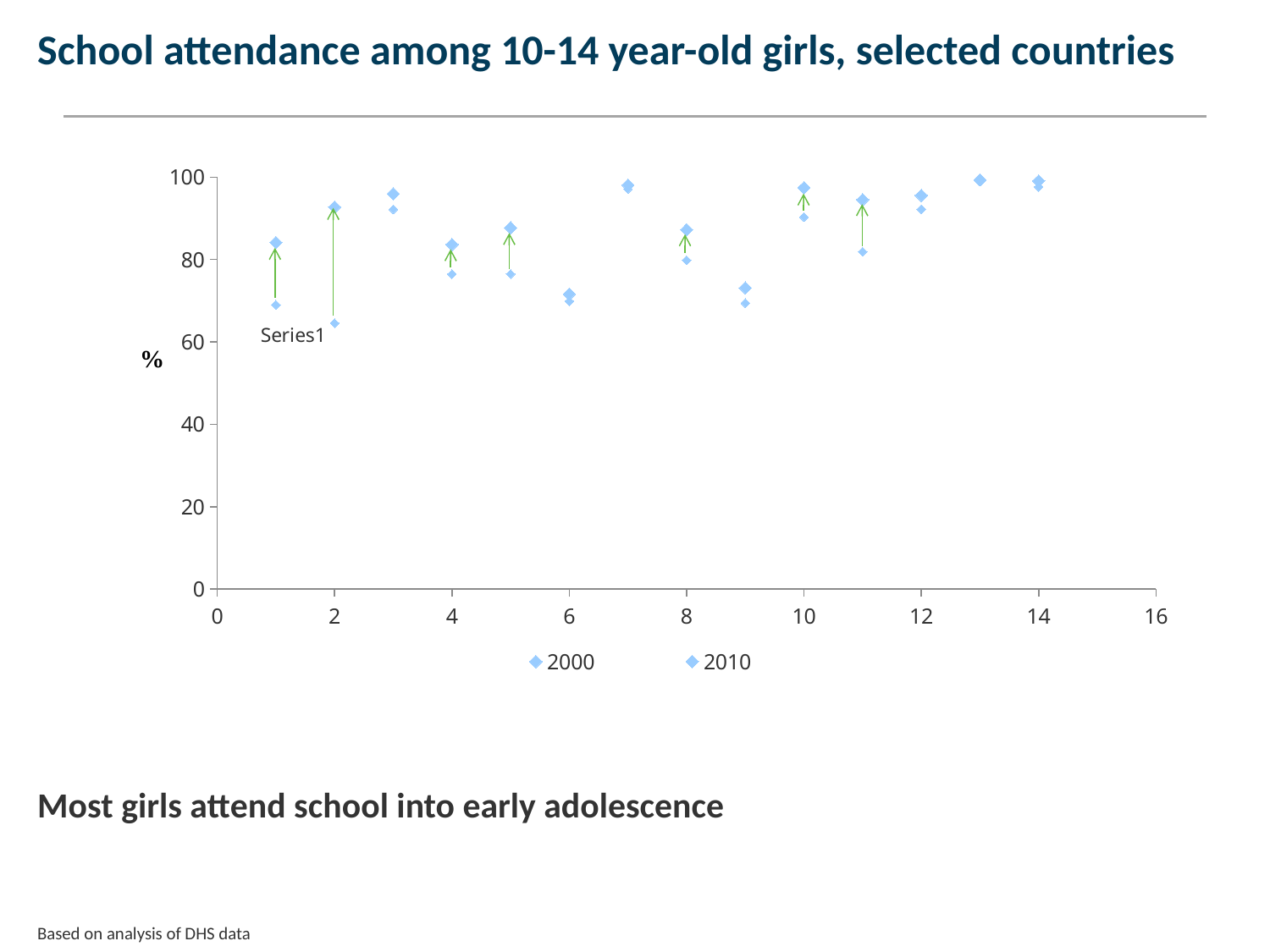
What is the title of the chart? School attendance among 10-14 year-old girls, selected countries Is the 2000 value at x = 2 greater or less than 80? less Is the 2010 value at x = 13 greater or less than 80? greater How many countries (x positions) have data points plotted? 14 How many series does the legend list? 2 Is the 2010 value at x = 6 greater or less than 80? less What kind of chart is shown on the slide? Scatter chart What are the two series named in the legend? 2000 and 2010 At x = 11, which series has the larger value, 2000 or 2010? 2010 At x = 2, which series has the larger value, 2000 or 2010? 2010 At which x position is the 2000 value the lowest? 2